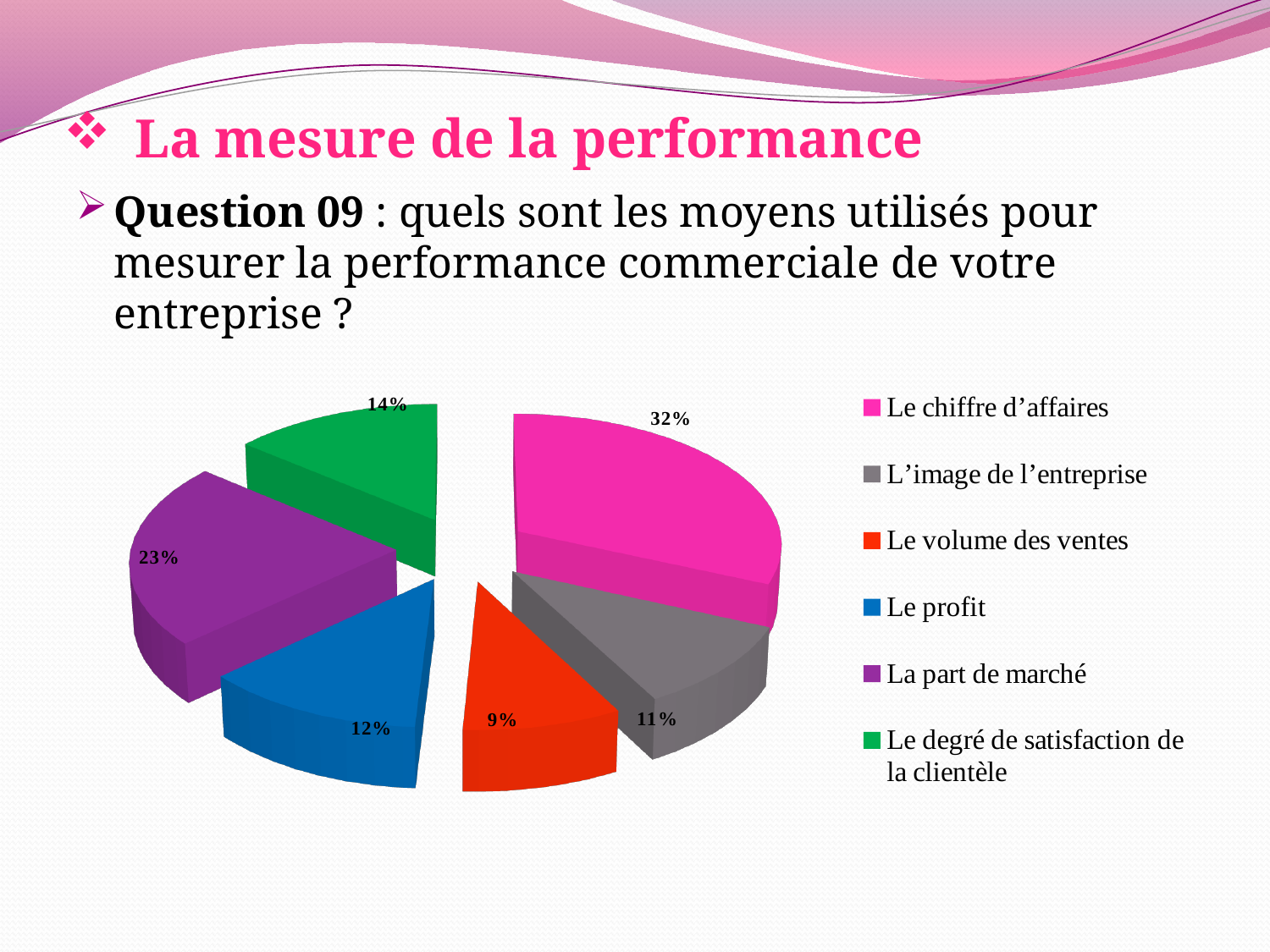
How many categories does the pie chart show? 6 What is the difference between the shares of "Le chiffre d'affaires" and "La part de marché"? 9% Which category has the smallest slice of the pie? Le volume des ventes What colour is the slice for "Le volume des ventes"? Red What is the value shown for "Le degré de satisfaction de la clientèle"? 14% Which is larger, the share for "Le profit" or the share for "L'image de l'entreprise"? Le profit What is the value shown for "Le profit"? 12% What is the difference between the shares of "Le degré de satisfaction de la clientèle" and "Le volume des ventes"? 5% What share of the pie does "La part de marché" represent? 23% What share of the pie does "Le chiffre d'affaires" represent? 32% What kind of chart is shown on the slide? Pie chart Which category has the largest slice of the pie? Le chiffre d'affaires